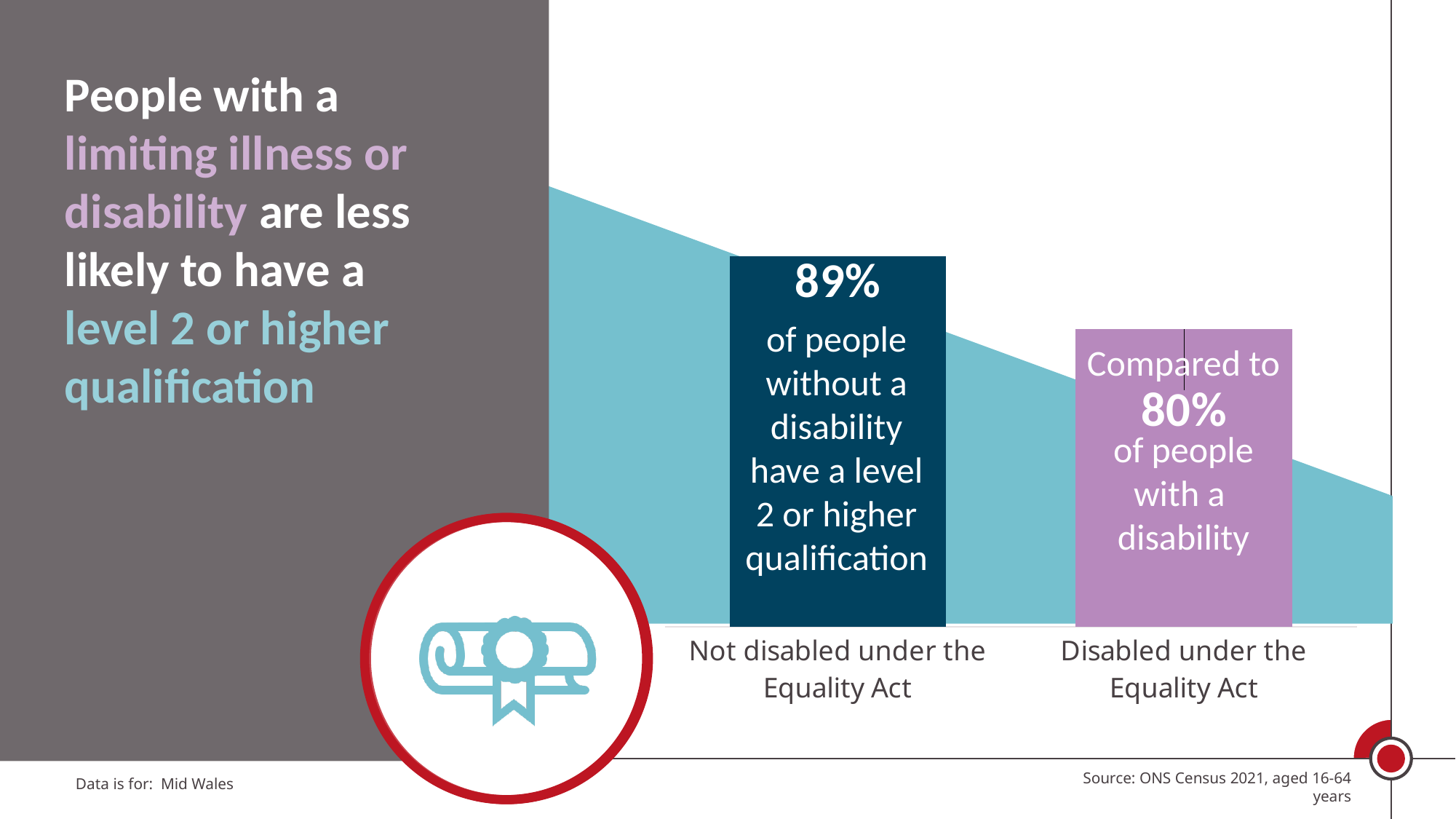
Do the values rise or fall from left to right across the categories? Fall Which category has the highest value on the chart? Not disabled under the Equality Act Which category has the higher value, 'Not disabled under the Equality Act' or 'Disabled under the Equality Act'? Not disabled under the Equality Act What area is the data on the slide for? Mid Wales What colour is the bar for 'Disabled under the Equality Act'? Purple What kind of chart is shown on the slide? Bar chart How many categories are shown on the chart? 2 What percentage of people disabled under the Equality Act have a level 2 or higher qualification? 80% What is the difference in percentage points between the 'Not disabled under the Equality Act' and 'Disabled under the Equality Act' values? 9 percentage points What percentage of people not disabled under the Equality Act have a level 2 or higher qualification? 89% Which category has the lowest value on the chart? Disabled under the Equality Act